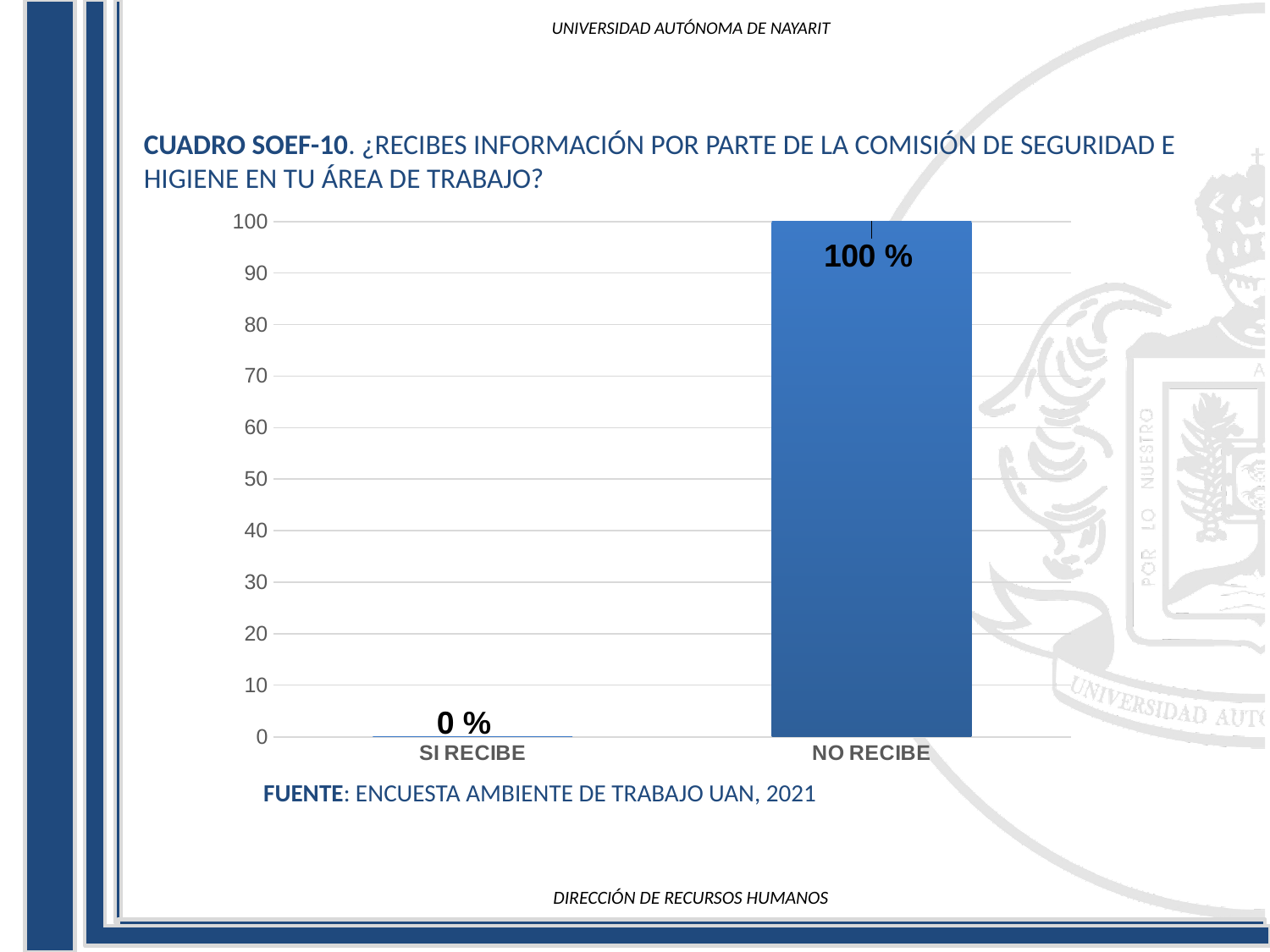
Is the value for NO RECIBE greater or less than 50? greater How many categories are shown on the x axis? 2 Which is larger, the value for SI RECIBE or the value for NO RECIBE? NO RECIBE What is the difference between the values for NO RECIBE and SI RECIBE? 100 % What is the highest value shown on the vertical axis? 100 What is the value for SI RECIBE? 0 % What source is cited below the chart? ENCUESTA AMBIENTE DE TRABAJO UAN, 2021 What kind of chart is shown on the slide? bar chart Which category has the lowest value? SI RECIBE What is the value for NO RECIBE? 100 % Which category has the highest value? NO RECIBE